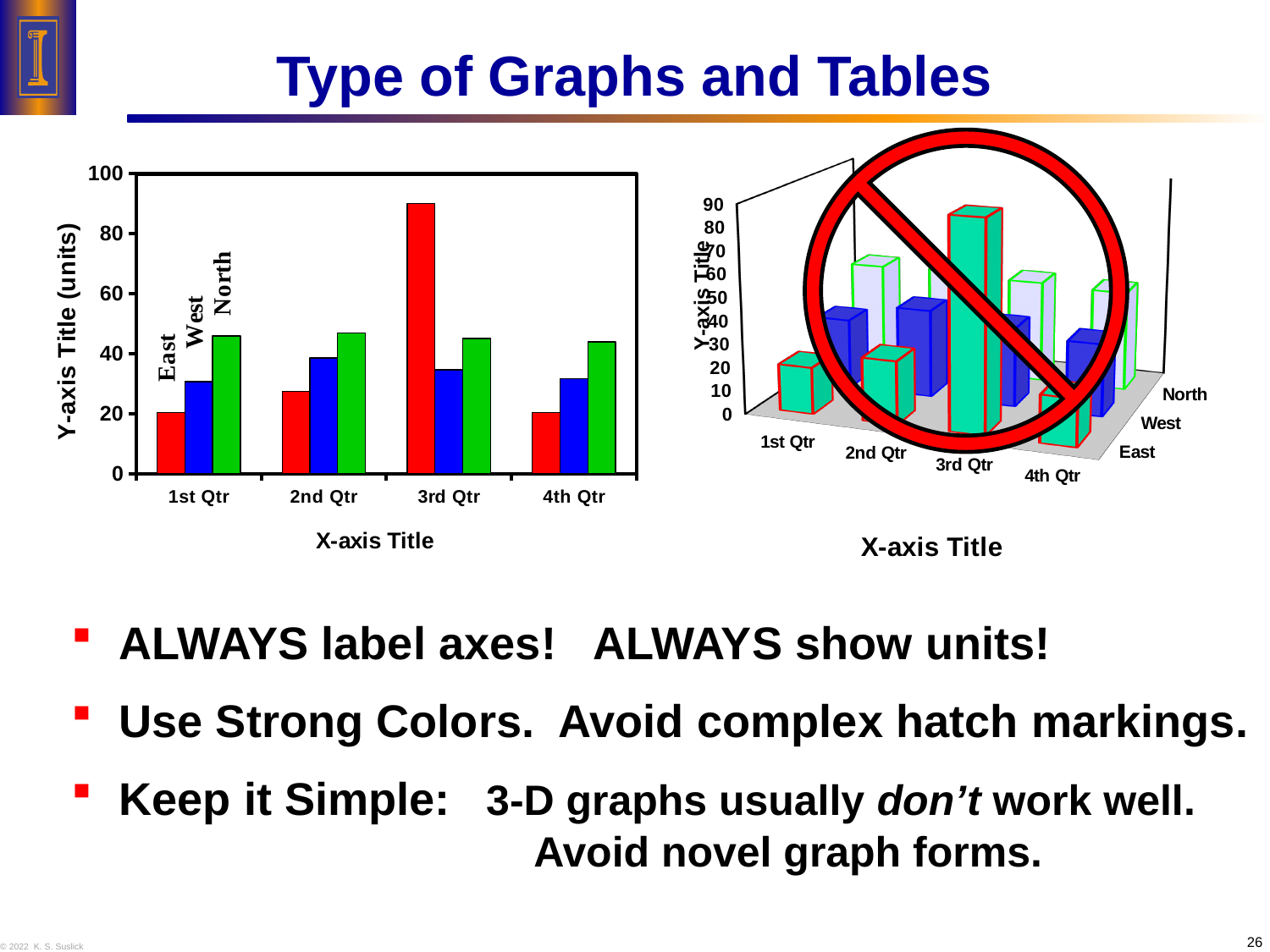
In the chart on the left, how many data series are plotted? 3 In the chart on the left, is the value for East in 1st Qtr greater or less than 40? less In the chart on the left, in which quarter is the East series highest? 3rd Qtr In the chart on the left, which is larger in 3rd Qtr, East or West? East In the chart on the left, is the value for West in 4th Qtr greater or less than 60? less In the chart on the right, how many quarters are shown on the x axis? 4 In the chart on the left, is the value for East in 3rd Qtr greater or less than 80? greater In the chart on the left, what is the y-axis title? Y-axis Title (units) What kind of chart is the chart on the left of the slide? bar chart In the chart on the left, which is larger in 1st Qtr, North or East? North In the chart on the left, how many quarters are shown on the x axis? 4